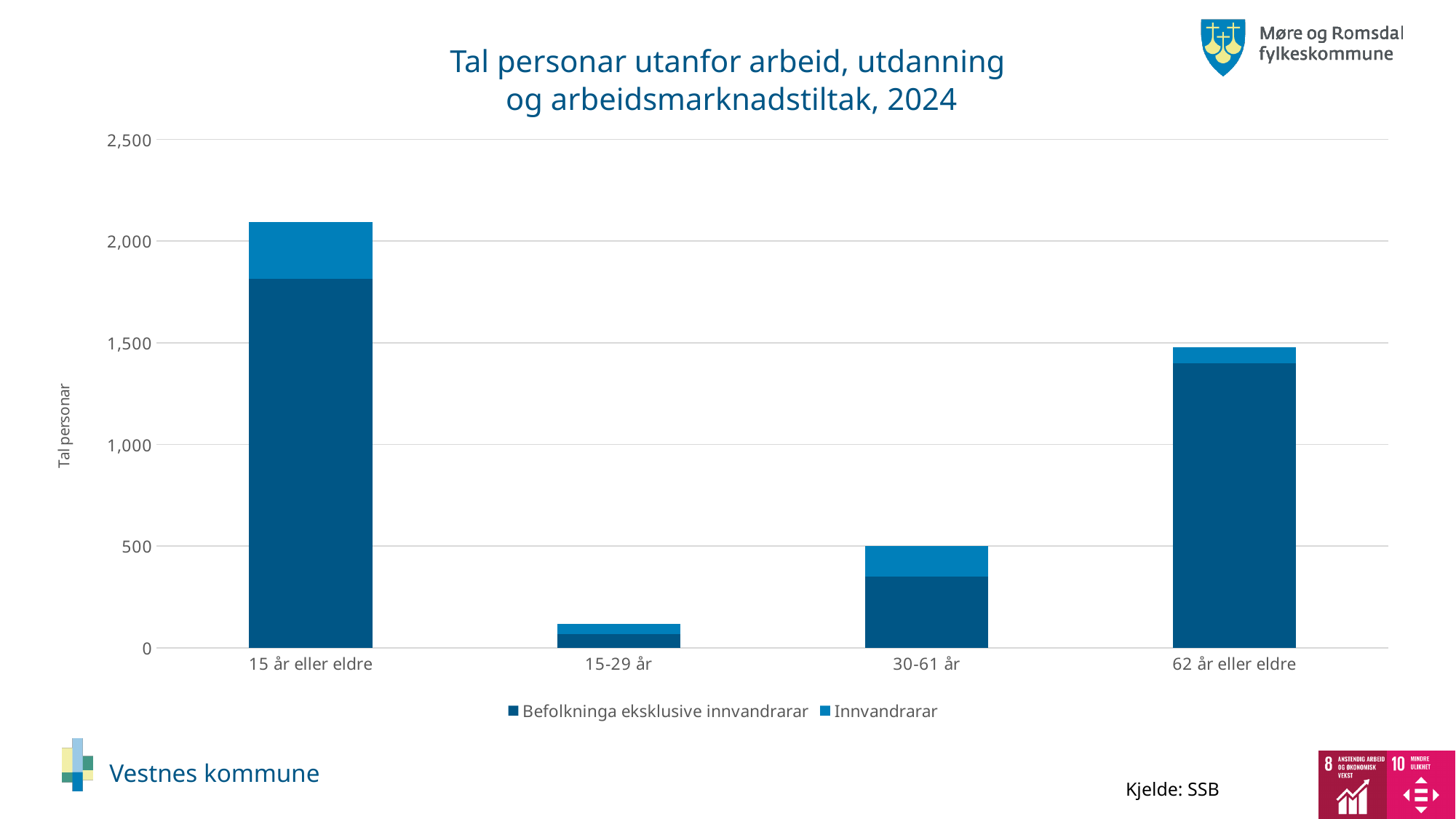
How many age categories are shown on the x axis? 4 Is the total stacked value for 15-29 år greater or less than 500? less Is the total stacked value for 15 år eller eldre greater or less than 2,000? greater Which stacked bar is taller: 62 år eller eldre or 30-61 år? 62 år eller eldre Is the total stacked value for 62 år eller eldre greater or less than 1,000? greater What kind of chart is shown on the slide? Stacked bar chart What is the source cited for the chart data? SSB How many series does the legend list? 2 What is the title of the y axis? Tal personar Which age category has the shortest stacked bar? 15-29 år Which age category has the tallest stacked bar? 15 år eller eldre